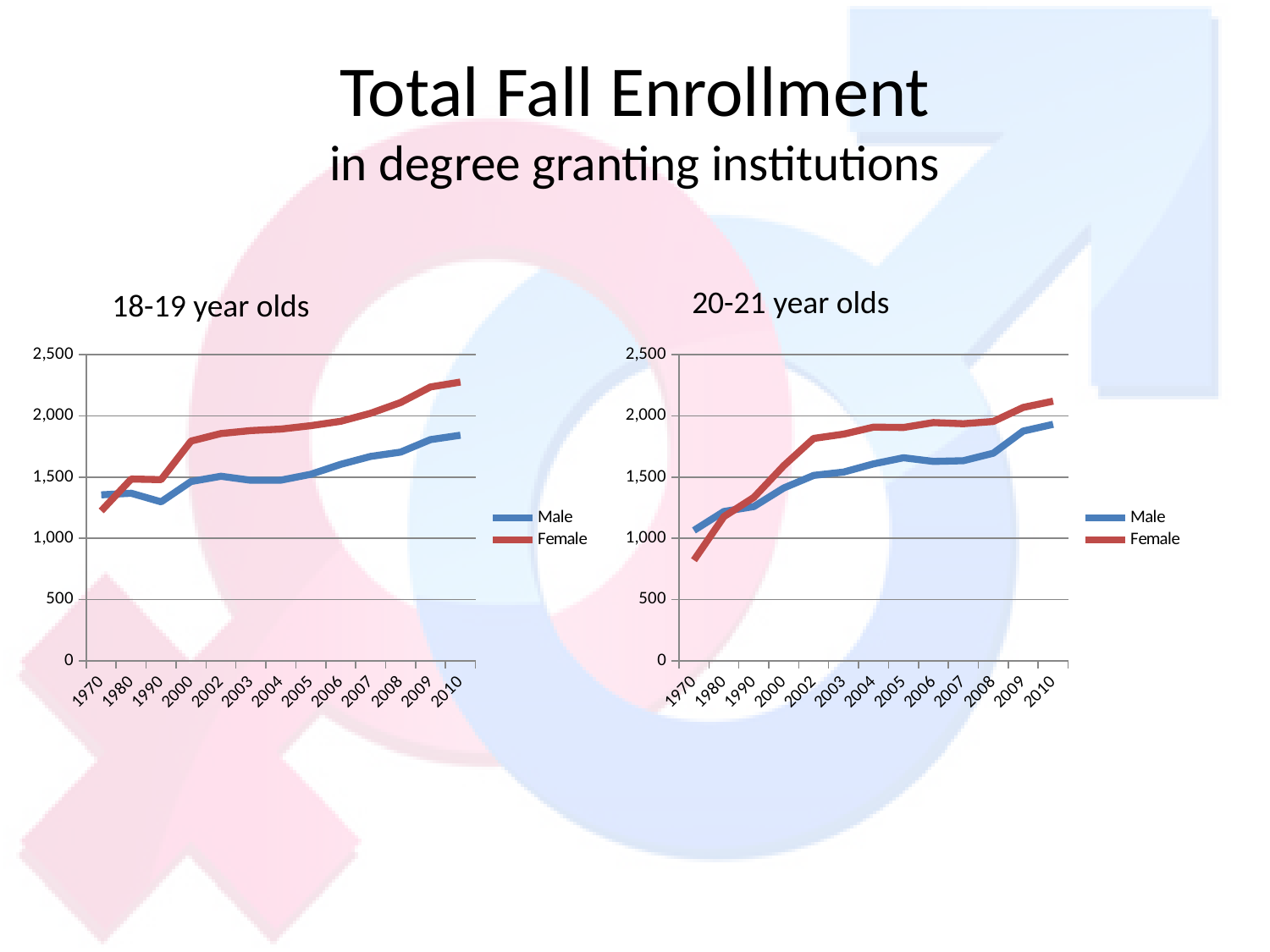
In the 20-21 year olds chart, which series has the larger value in 2010, Male or Female? Female How many series does the legend of the 20-21 year olds chart list? 2 In the 18-19 year olds chart, which series has the larger value in 1970, Male or Female? Male In the 20-21 year olds chart, is the Female value for 1970 greater or less than 1,000? less In the 20-21 year olds chart, does the Female series generally rise or fall from 1970 to 2010? rise In the 18-19 year olds chart, is the Male value for 2010 greater or less than 2,000? less What is the title of the chart on the right of the slide? 20-21 year olds In the 18-19 year olds chart, is the Female value for 2010 greater or less than 2,000? greater How many years are shown on the x axis of the 18-19 year olds chart? 13 What colour is the Female line in the 18-19 year olds chart? red What kind of chart is the 18-19 year olds chart? line chart